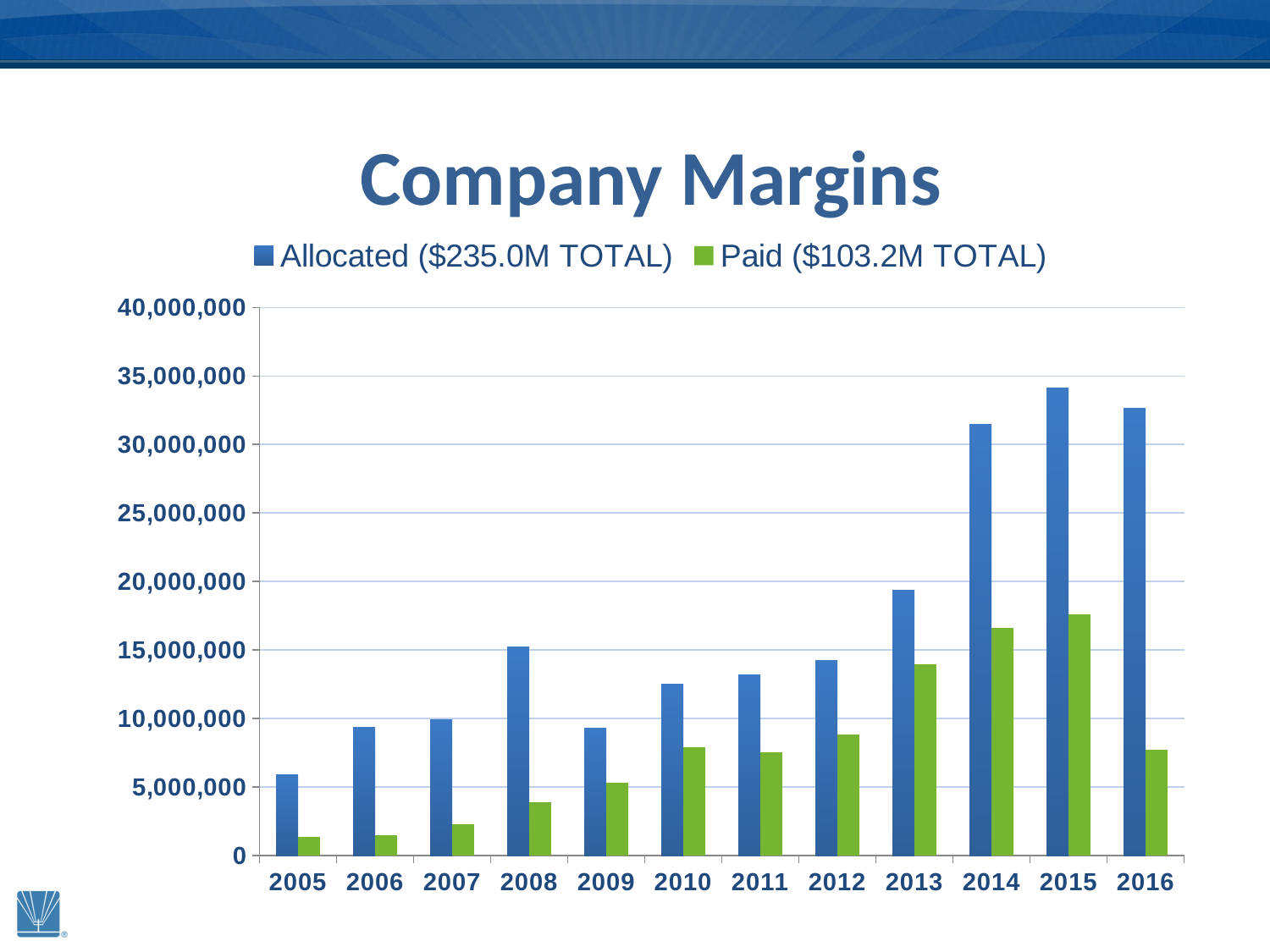
In which year is the Allocated value highest? 2015 In which year is the Paid value highest? 2015 How many years are shown on the x axis? 12 Do the Allocated values rise or fall from 2013 to 2015? rise Is the Paid value for 2016 greater or less than 10,000,000? less Which is larger, the Allocated value for 2008 or the Allocated value for 2009? 2008 Is the Allocated value for 2014 greater or less than 30,000,000? greater What total is given in the legend for the Allocated series? $235.0M TOTAL What is the title of the chart? Company Margins In which year is the Allocated value lowest? 2005 What kind of chart is shown on the slide? bar chart How many series does the legend list? 2